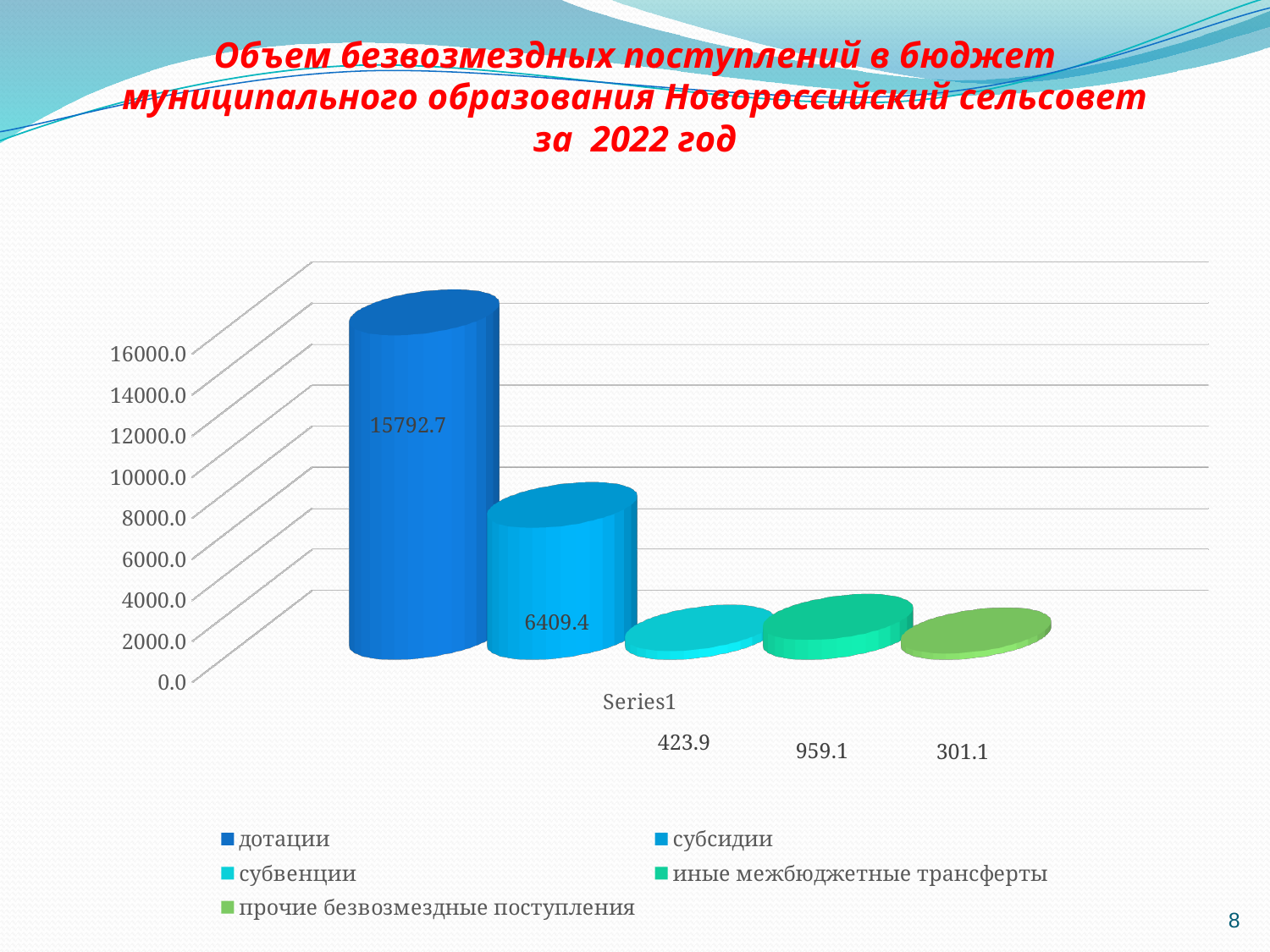
What kind of chart is shown on the slide? bar chart How many series does the legend list? 5 What is the value for дотации? 15792.7 What is the value for субвенции? 423.9 What is the value for иные межбюджетные трансферты? 959.1 Which series has the highest value? дотации What is the difference between the values for дотации and субсидии? 9383.3 Which series has the lowest value? прочие безвозмездные поступления Is the value for субсидии greater or less than 8000.0? less What is the value for субсидии? 6409.4 What is the value for прочие безвозмездные поступления? 301.1 Which is larger, the value for субвенции or the value for иные межбюджетные трансферты? иные межбюджетные трансферты